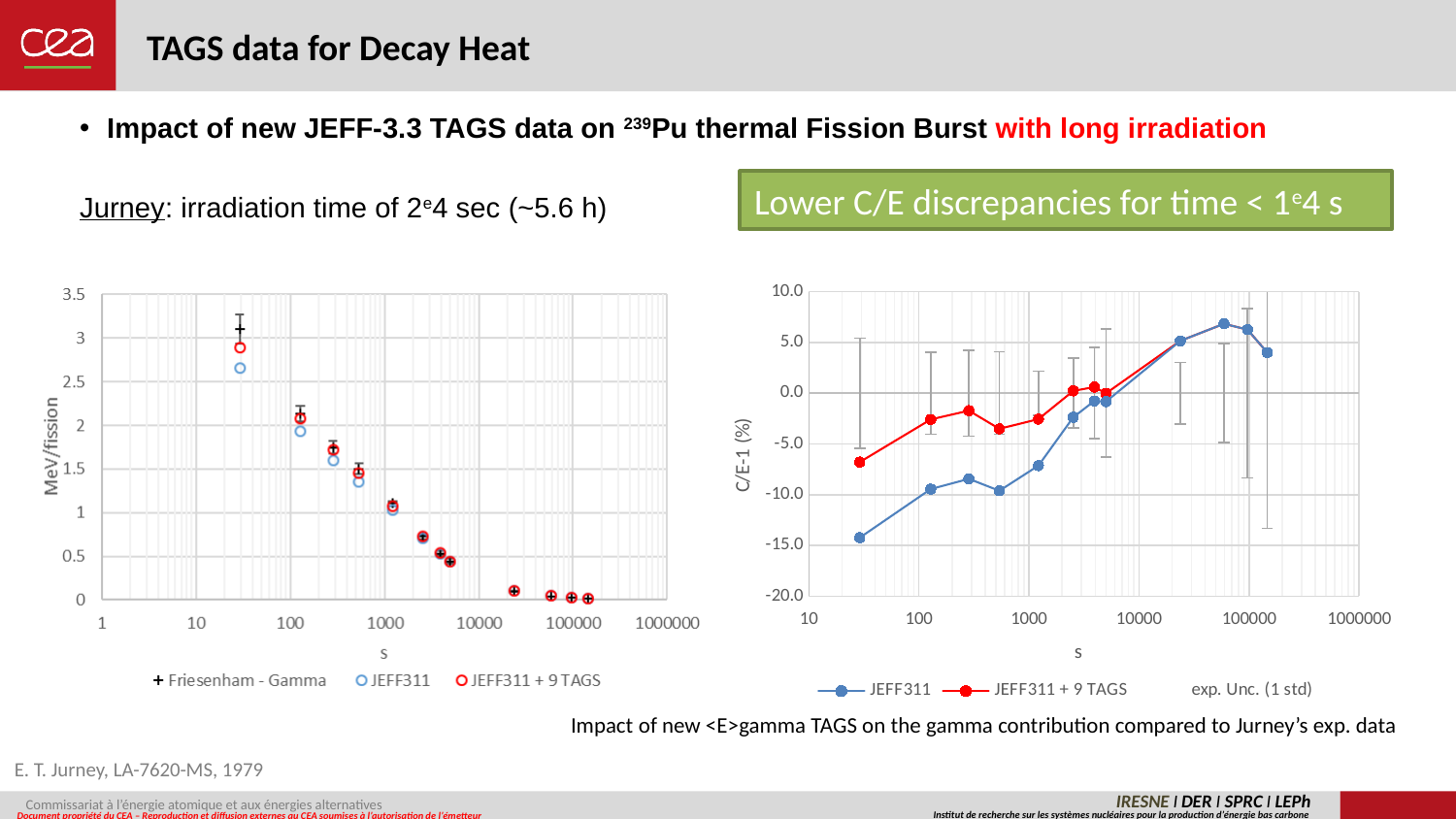
In the right chart, does the JEFF311 series overall rise or fall as s increases? rise How many series does the legend of the left chart list? 3 What kind of chart is the right chart (C/E-1 (%) vs s)? line chart In the left chart, do the MeV/fission values rise or fall as s increases? fall In the right chart, is the JEFF311 + 9 TAGS value at the smallest s (leftmost point) greater or less than -10.0? greater In the left chart, is the Friesenham - Gamma value at the smallest s (leftmost point) greater or less than 3? greater In the left chart, is the JEFF311 value at the smallest s (leftmost point) greater or less than 3? less In the right chart, at the smallest s (leftmost point), which series has the higher C/E-1 value, JEFF311 or JEFF311 + 9 TAGS? JEFF311 + 9 TAGS What kind of chart is the left chart (MeV/fission vs s)? scatter chart How many entries does the legend of the right chart list? 3 What is the y-axis label of the right chart? C/E-1 (%)